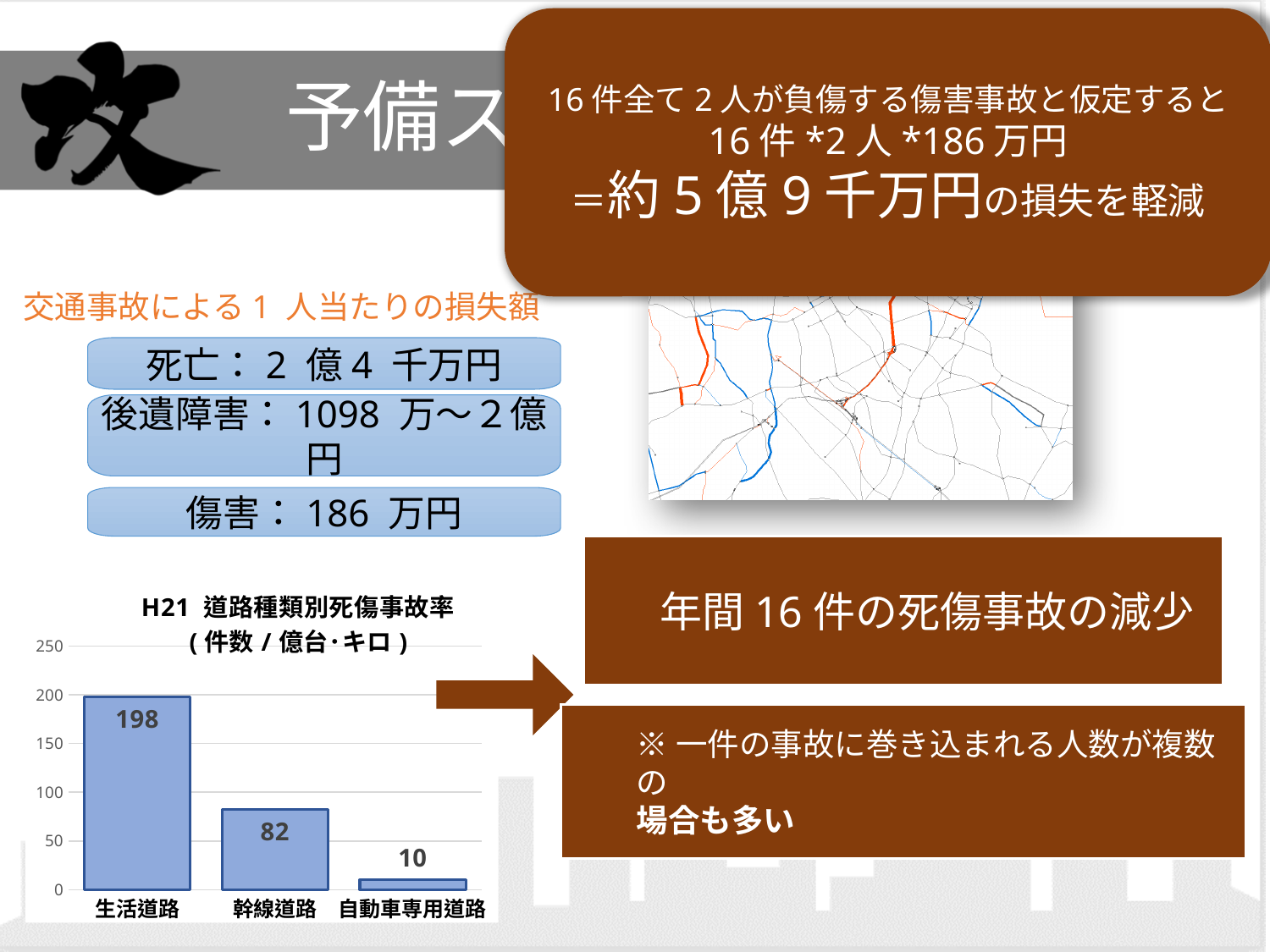
Which road type has the highest value in the H21 道路種類別死傷事故率 chart? 生活道路 What is the difference between the values for 生活道路 and 幹線道路 in the H21 道路種類別死傷事故率 chart? 116 What is the value for 幹線道路 in the H21 道路種類別死傷事故率 chart? 82 Which road type has the lowest value in the H21 道路種類別死傷事故率 chart? 自動車専用道路 How many road types are shown in the H21 道路種類別死傷事故率 chart? 3 What is the value for 生活道路 in the H21 道路種類別死傷事故率 chart? 198 Do the values in the H21 道路種類別死傷事故率 chart rise or fall from left to right along the x axis? fall What is the value for 自動車専用道路 in the H21 道路種類別死傷事故率 chart? 10 What is the difference between the values for 幹線道路 and 自動車専用道路 in the H21 道路種類別死傷事故率 chart? 72 Is the value for 幹線道路 in the H21 道路種類別死傷事故率 chart greater or less than 100? less What kind of chart is the H21 道路種類別死傷事故率 chart? bar chart Which is larger in the H21 道路種類別死傷事故率 chart, the value for 幹線道路 or 自動車専用道路? 幹線道路